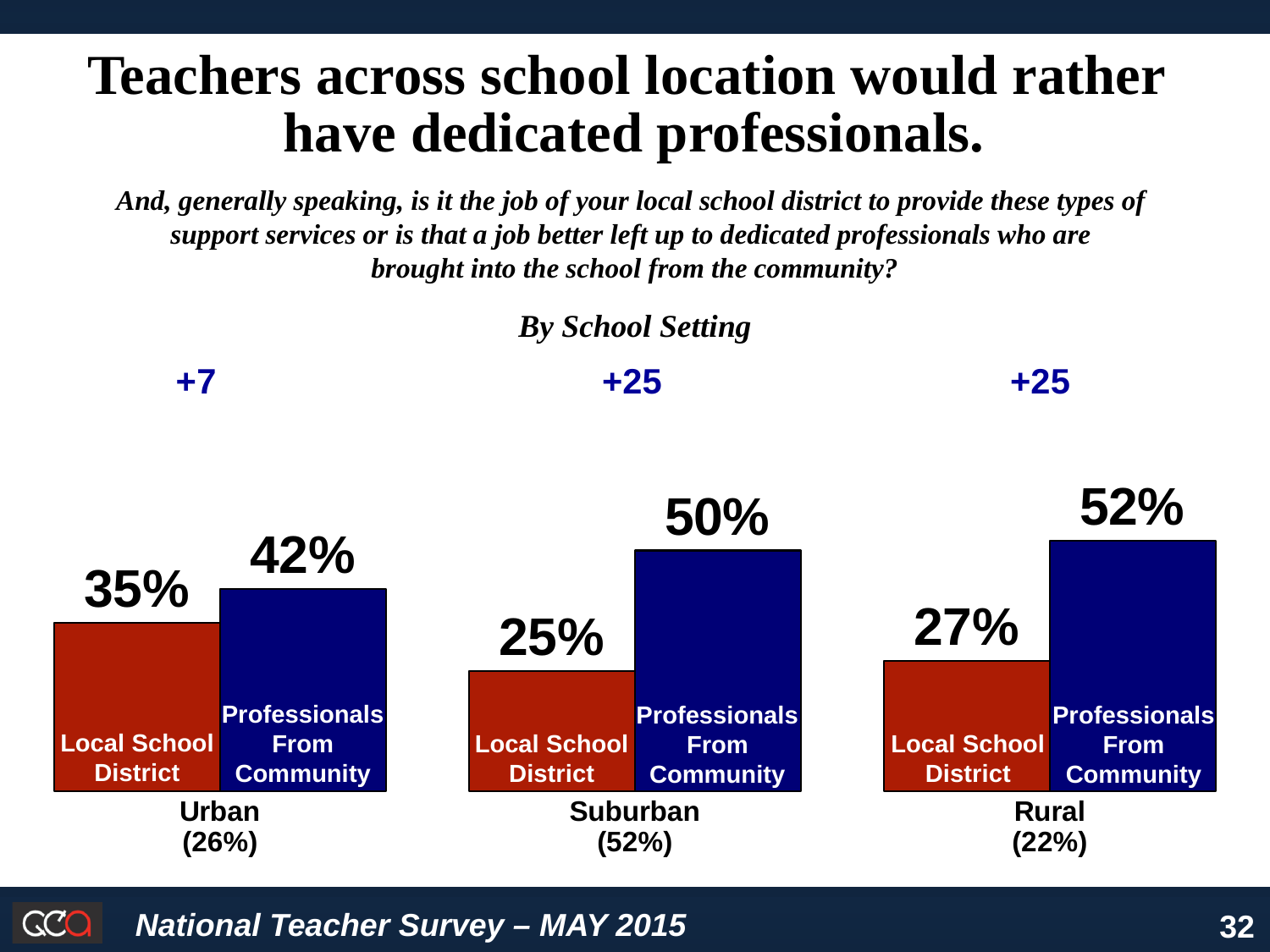
Which school setting has the highest value for Professionals From Community? Rural What percentage of Rural teachers said Local School District? 27% What share of the sample is Suburban, as shown under the Suburban label? 52% What is the difference between Professionals From Community and Local School District for Suburban teachers? 25 For Urban teachers, which is larger: Local School District or Professionals From Community? Professionals From Community Which school setting has the lowest value for Local School District? Suburban What percentage of Suburban teachers said Professionals From Community? 50% What kind of chart is shown on the slide? Bar chart What percentage of Urban teachers said Local School District? 35% What is the difference between Professionals From Community and Local School District for Urban teachers? 7 What percentage of Rural teachers said Professionals From Community? 52% How many school settings are shown in the chart? 3